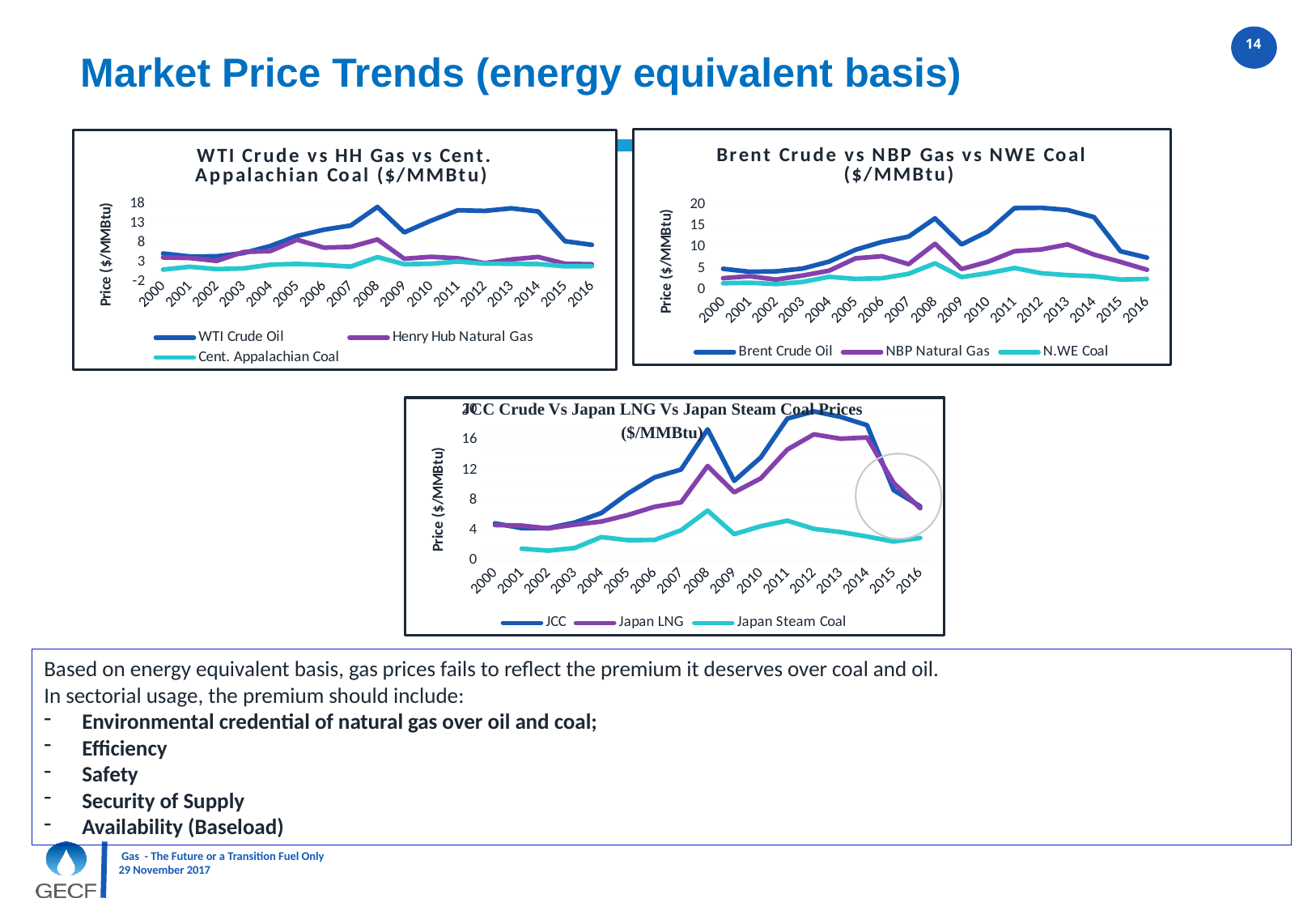
How many series does the legend of the 'Brent Crude vs NBP Gas vs NWE Coal' chart list? 3 How many years are shown on the x axis of the 'JCC Crude Vs Japan LNG Vs Japan Steam Coal Prices' chart? 17 In the 'JCC Crude Vs Japan LNG Vs Japan Steam Coal Prices' chart, is the JCC value in 2012 greater or less than 16? greater In the 'Brent Crude vs NBP Gas vs NWE Coal' chart, which series has the highest value in 2012? Brent Crude Oil In the 'Brent Crude vs NBP Gas vs NWE Coal' chart, is the Brent Crude Oil value in 2012 greater or less than 15? greater What type of chart is the 'WTI Crude vs HH Gas vs Cent. Appalachian Coal' chart? line chart What is the y-axis label on the 'Brent Crude vs NBP Gas vs NWE Coal' chart? Price ($/MMBtu) In the 'WTI Crude vs HH Gas vs Cent. Appalachian Coal' chart, is the WTI Crude Oil value in 2008 greater or less than 13? greater In the 'WTI Crude vs HH Gas vs Cent. Appalachian Coal' chart, which series is higher in 2008, WTI Crude Oil or Henry Hub Natural Gas? WTI Crude Oil In the 'JCC Crude Vs Japan LNG Vs Japan Steam Coal Prices' chart, which series has the lowest value in 2008? Japan Steam Coal In the 'Brent Crude vs NBP Gas vs NWE Coal' chart, does the Brent Crude Oil line rise or fall from 2012 to 2016? fall